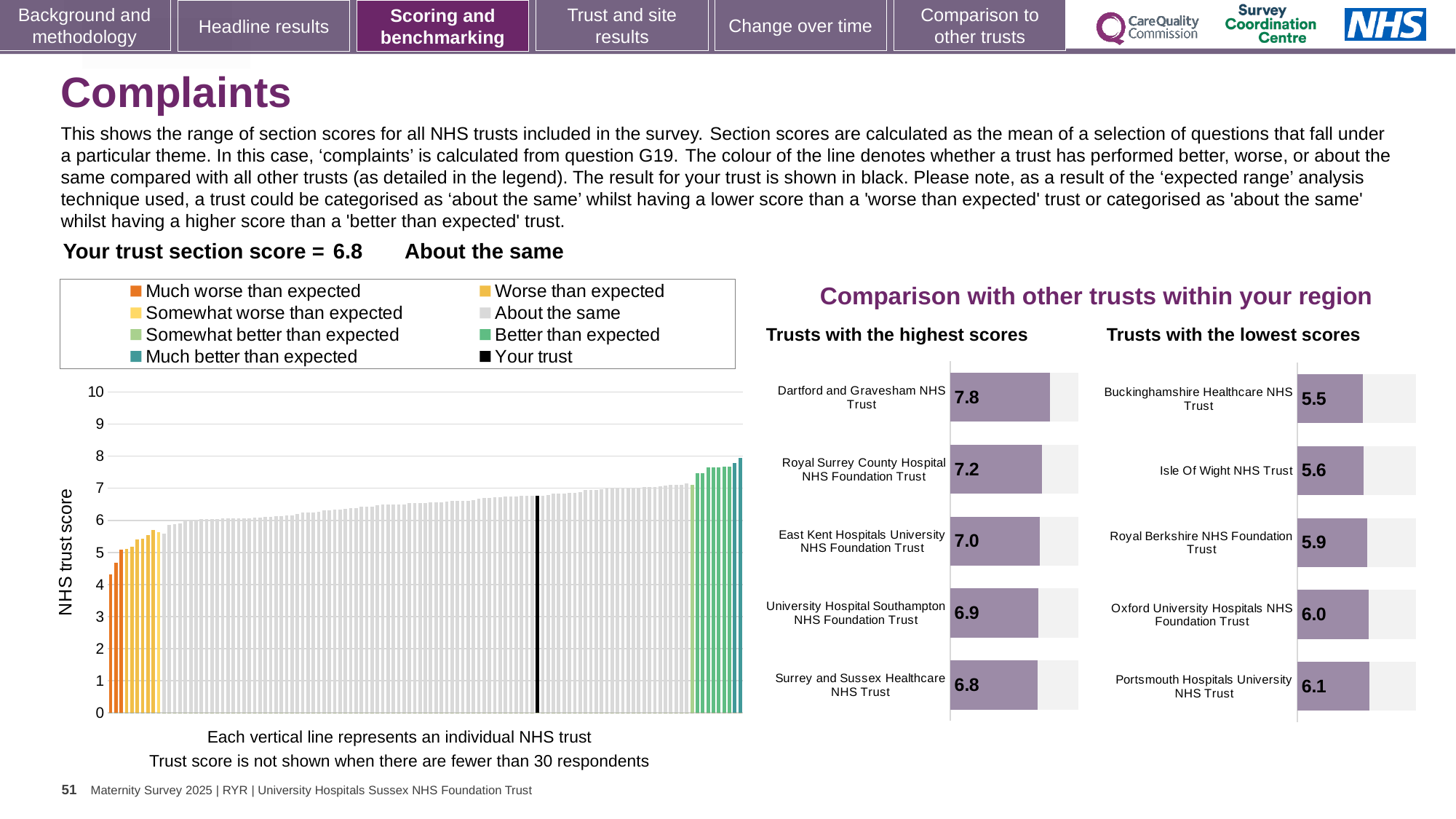
In the 'Trusts with the lowest scores' chart, which has the higher score: Isle Of Wight NHS Trust or Oxford University Hospitals NHS Foundation Trust? Oxford University Hospitals NHS Foundation Trust In the 'Trusts with the highest scores' chart, what is the difference between the scores of Dartford and Gravesham NHS Trust and Surrey and Sussex Healthcare NHS Trust? 1.0 How many entries does the legend of the large NHS trust score chart on the left list? 8 In the 'Trusts with the highest scores' chart, what is the score for Dartford and Gravesham NHS Trust? 7.8 In the 'Trusts with the lowest scores' chart, which trust has the lowest score? Buckinghamshire Healthcare NHS Trust In the 'Trusts with the lowest scores' chart, what is the score for Royal Berkshire NHS Foundation Trust? 5.9 In the large NHS trust score chart on the left, is the value for the lowest (leftmost) trust greater or less than 5? less In the large NHS trust score chart on the left, do the values rise or fall from left to right along the x axis? rise In the 'Trusts with the highest scores' chart, what is the score for East Kent Hospitals University NHS Foundation Trust? 7.0 How many trusts are shown in the 'Trusts with the highest scores' chart? 5 In the 'Trusts with the lowest scores' chart, what is the difference between the scores of Portsmouth Hospitals University NHS Trust and Buckinghamshire Healthcare NHS Trust? 0.6 In the 'Trusts with the highest scores' chart, which trust has the highest score? Dartford and Gravesham NHS Trust